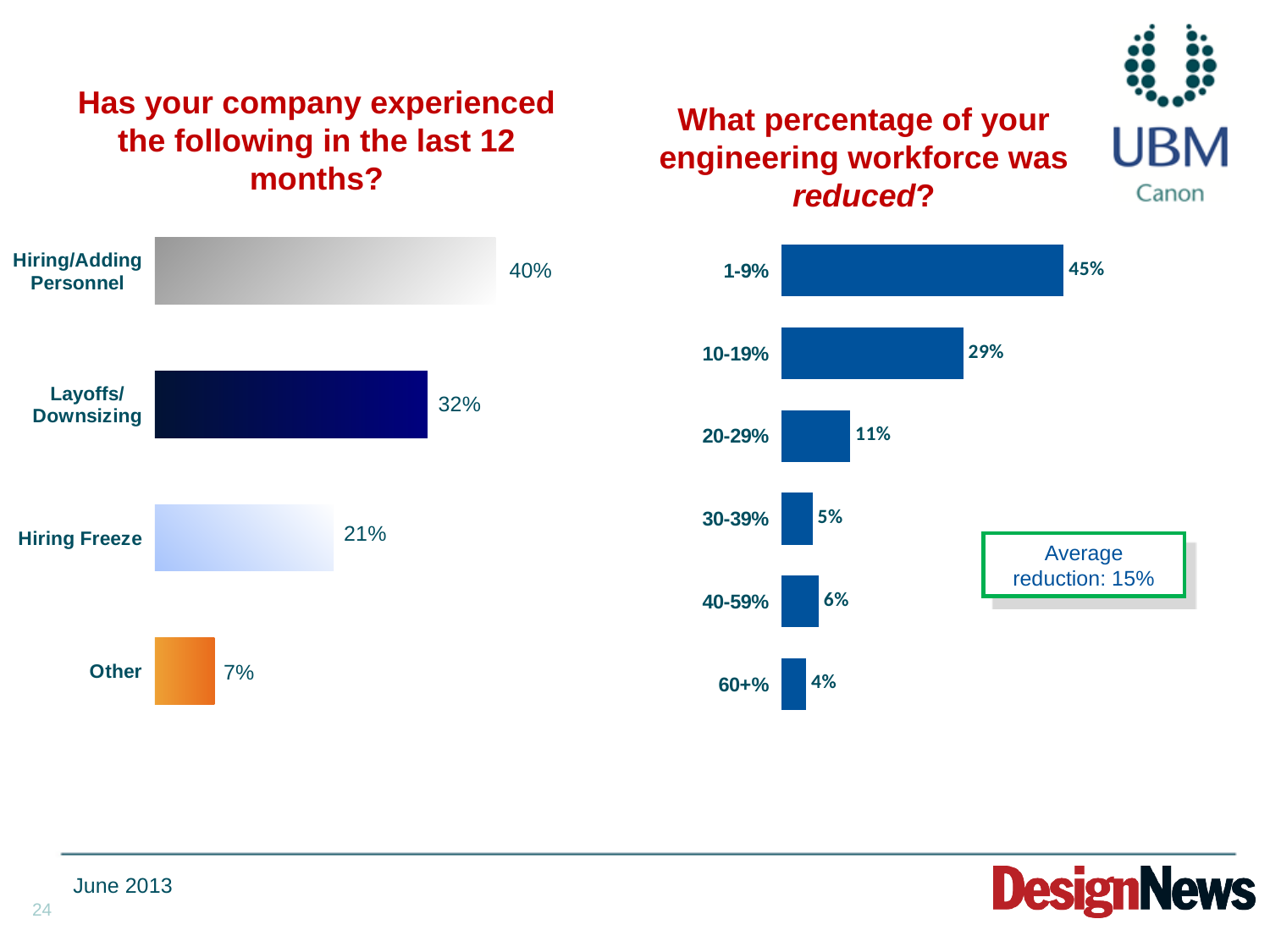
What kind of chart is the left chart ('Has your company experienced the following in the last 12 months?')? Bar chart In the left chart ('Has your company experienced the following in the last 12 months?'), what is the value for Layoffs/Downsizing? 32% In the left chart ('Has your company experienced the following in the last 12 months?'), how many categories are shown? 4 In the right chart ('What percentage of your engineering workforce was reduced?'), which category has the highest value? 1-9% In the right chart ('What percentage of your engineering workforce was reduced?'), what is the value for 10-19%? 29% In the left chart ('Has your company experienced the following in the last 12 months?'), what is the difference between Hiring/Adding Personnel and Hiring Freeze? 19% In the left chart ('Has your company experienced the following in the last 12 months?'), which category has the lowest value? Other In the right chart ('What percentage of your engineering workforce was reduced?'), what average reduction is stated in the text box? 15% In the right chart ('What percentage of your engineering workforce was reduced?'), which is larger, 20-29% or 30-39%? 20-29% In the right chart ('What percentage of your engineering workforce was reduced?'), what is the value for 40-59%? 6% In the right chart ('What percentage of your engineering workforce was reduced?'), how many categories are shown? 6 In the left chart ('Has your company experienced the following in the last 12 months?'), which category has the highest value? Hiring/Adding Personnel